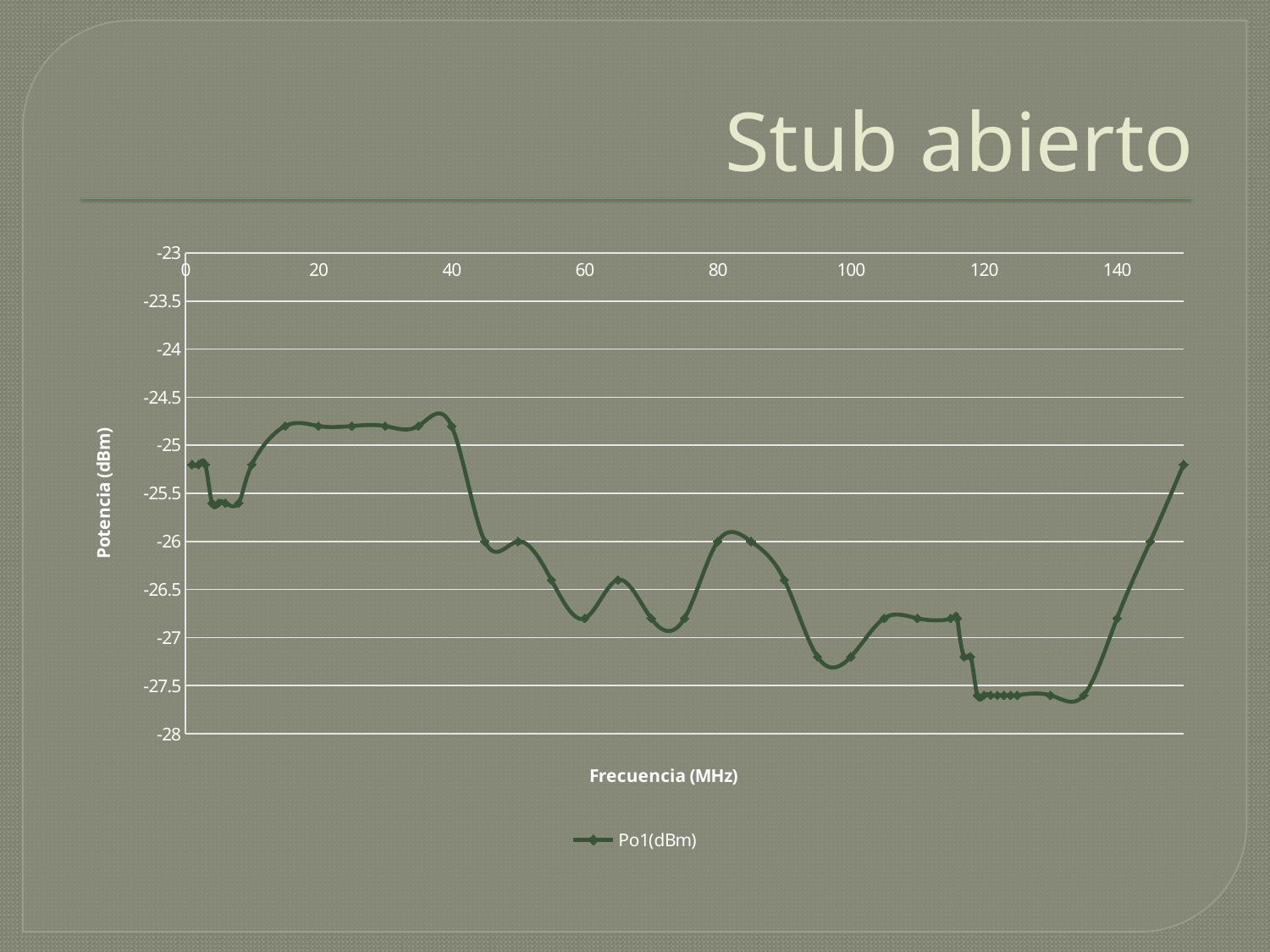
Which has the higher Po1(dBm) value, 20 MHz or 120 MHz? 20 MHz How many series does the legend list? 1 Between 40 MHz and 60 MHz, does the Po1(dBm) value rise or fall? fall What is the name of the series shown in the legend? Po1(dBm) Is the value for Po1(dBm) at 20 MHz greater or less than -25? greater Is the value for Po1(dBm) at 60 MHz greater or less than -26.5? less Is the value for Po1(dBm) at 100 MHz greater or less than -27? less What is the title of the x axis? Frecuencia (MHz) What kind of chart is shown on the slide? line chart Between 130 MHz and 150 MHz, does the Po1(dBm) value rise or fall? rise